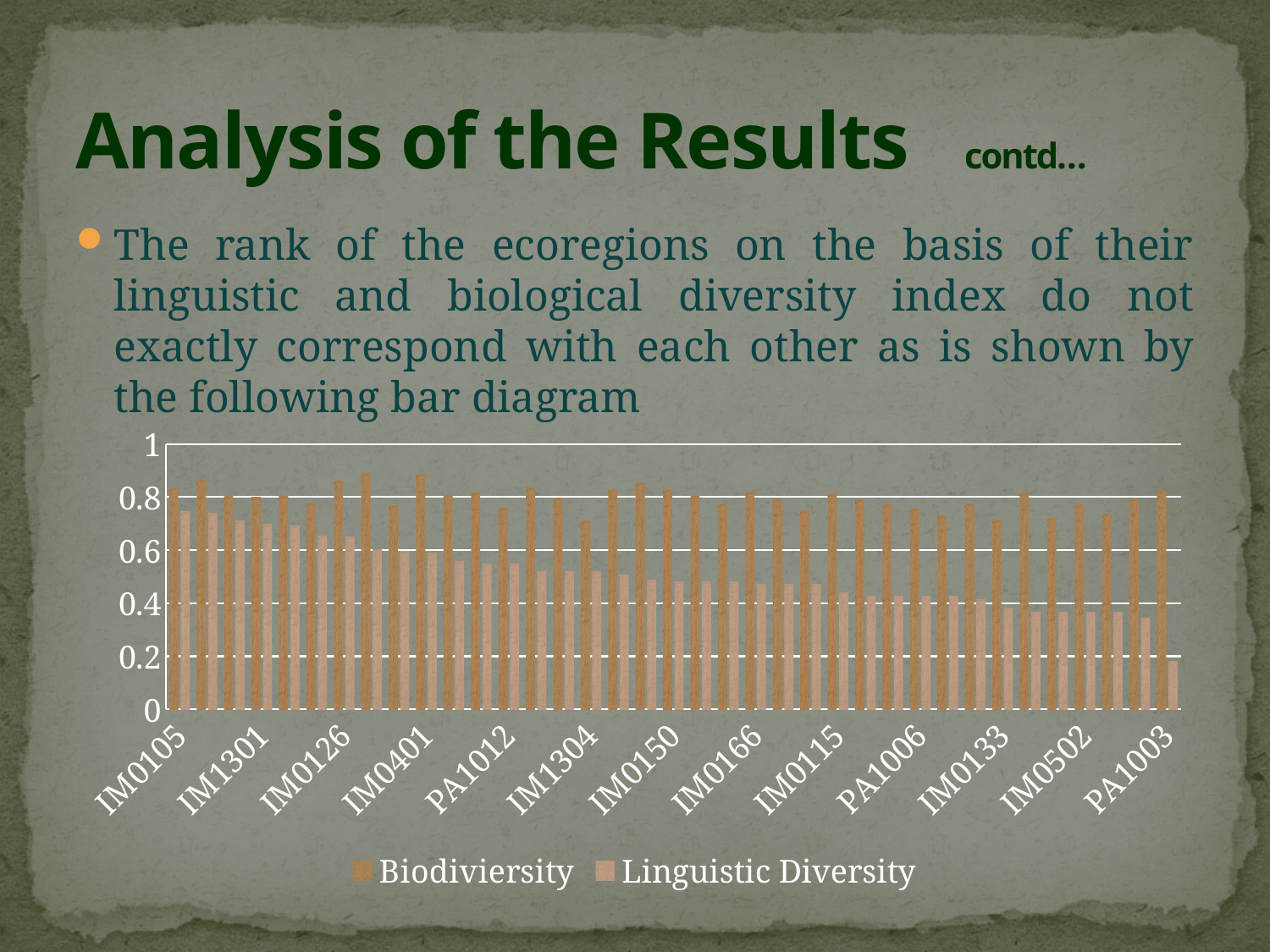
Do the Linguistic Diversity values generally rise or fall from left to right along the x axis? fall For PA1003, which series has the larger value, Biodiviersity or Linguistic Diversity? Biodiviersity Is the Biodiviersity value for IM0401 greater or less than 0.6? greater Is the Linguistic Diversity value for IM0105 greater or less than 0.6? greater What is the highest value shown on the vertical axis? 1 Is the Linguistic Diversity value for IM0502 greater or less than 0.6? less Which labelled category has the lowest Linguistic Diversity value? PA1003 What kind of chart is shown on the slide? bar chart What are the two series named in the chart legend? Biodiviersity and Linguistic Diversity How many series does the chart legend list? 2